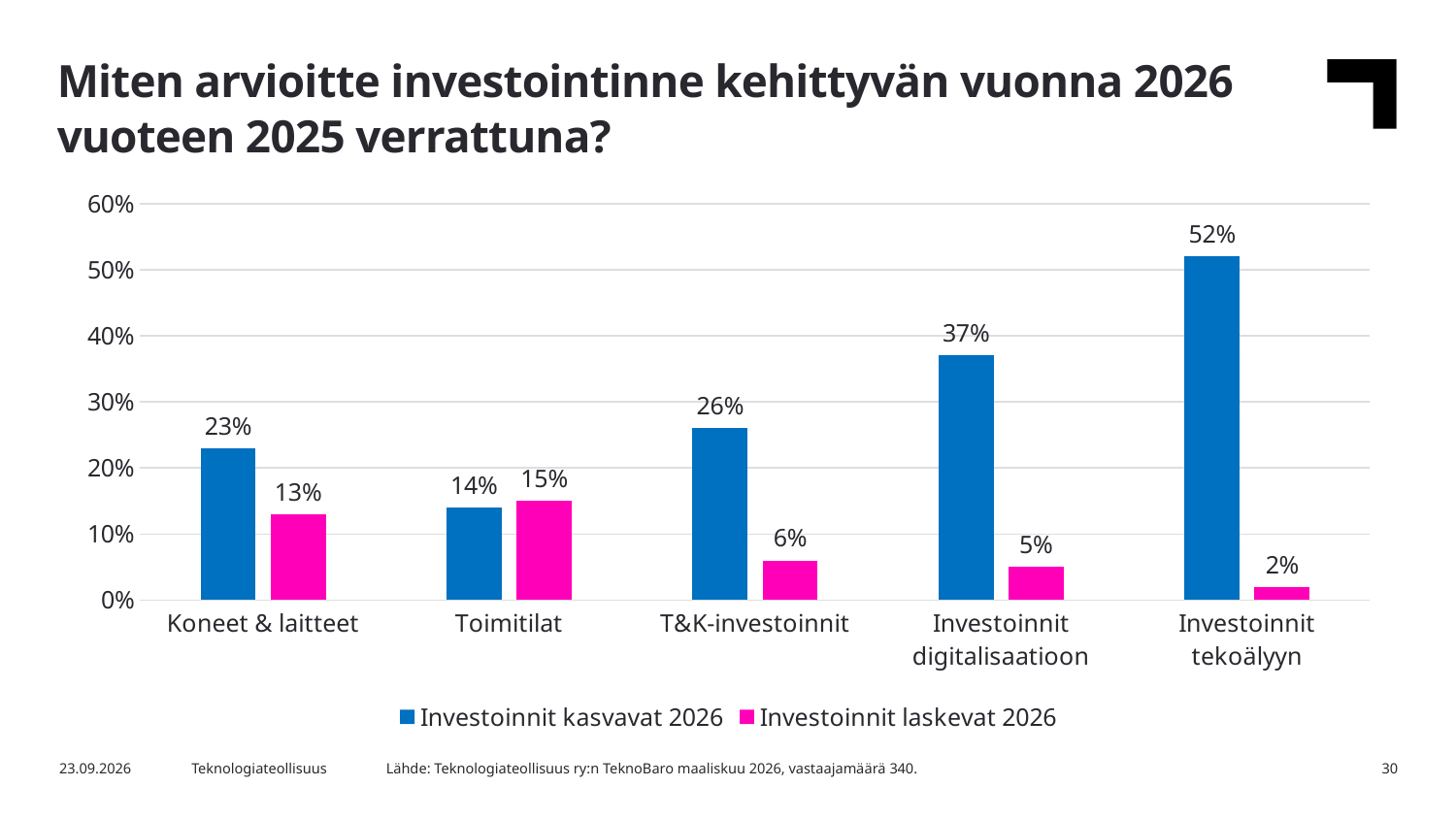
What is the difference between 'Investoinnit kasvavat 2026' and 'Investoinnit laskevat 2026' for 'Investoinnit digitalisaatioon'? 32 percentage points How many categories are shown on the x axis? 5 What is the value for 'Investoinnit laskevat 2026' in the 'Koneet & laitteet' category? 13% Is the value for 'Investoinnit kasvavat 2026' in 'Investoinnit digitalisaatioon' greater or less than 30%? greater How many series does the legend list? 2 In the 'Toimitilat' category, which series has the larger value: 'Investoinnit kasvavat 2026' or 'Investoinnit laskevat 2026'? Investoinnit laskevat 2026 What is the value for 'Investoinnit kasvavat 2026' in the 'Investoinnit tekoälyyn' category? 52% What colour are the bars for 'Investoinnit laskevat 2026'? Pink (magenta) What kind of chart is shown on the slide? Bar chart What is the value for 'Investoinnit kasvavat 2026' in the 'T&K-investoinnit' category? 26% Which category has the highest value for 'Investoinnit kasvavat 2026'? Investoinnit tekoälyyn Which category has the lowest value for 'Investoinnit laskevat 2026'? Investoinnit tekoälyyn